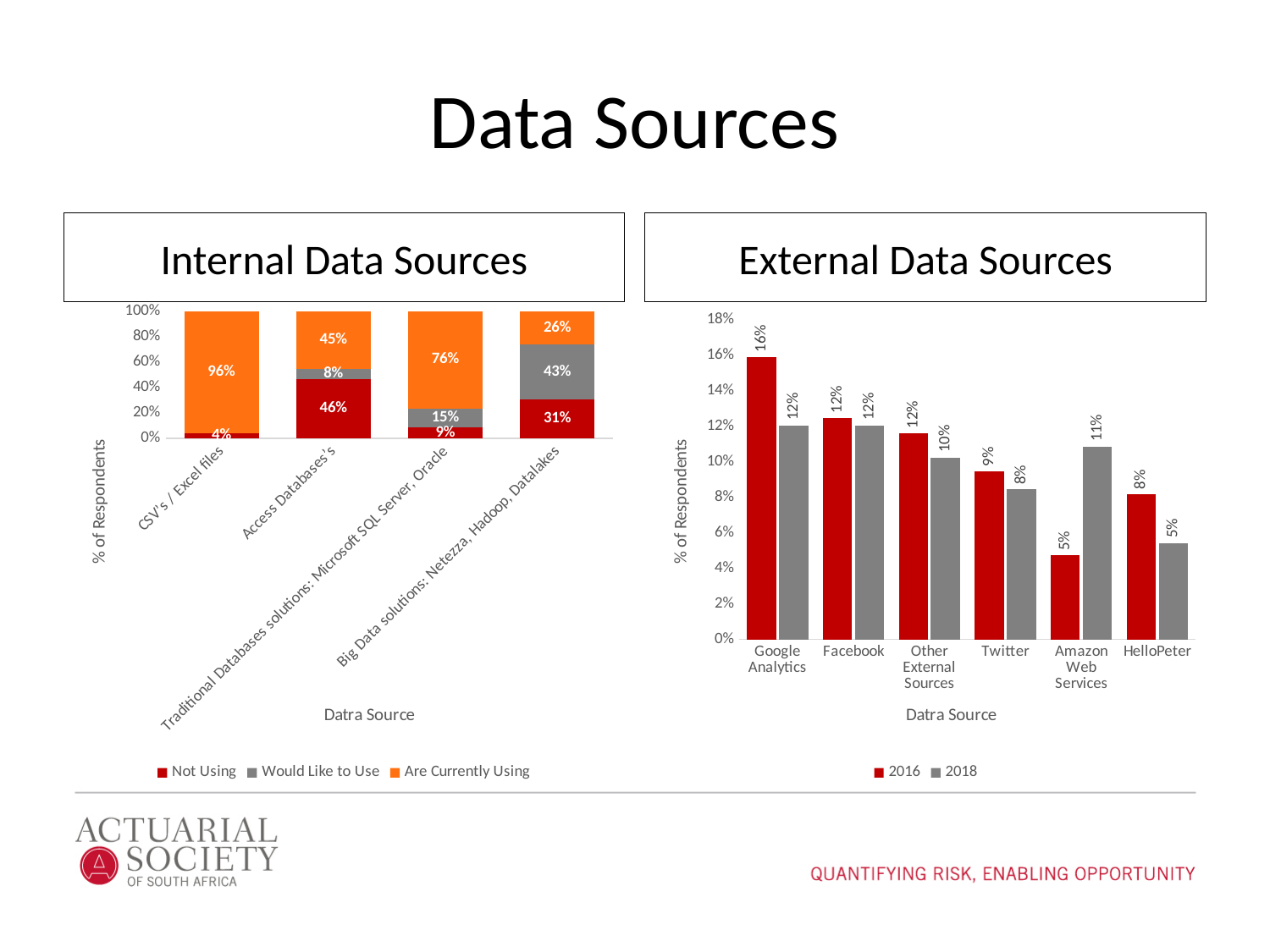
How many categories are shown on the x axis of the External Data Sources chart? 6 In the External Data Sources chart, which is larger for Amazon Web Services: the 2016 value or the 2018 value? 2018 What type of chart is the Internal Data Sources chart? Stacked bar chart In the External Data Sources chart, which category has the highest 2016 value? Google Analytics In the Internal Data Sources chart, what is the 'Would Like to Use' value for Big Data solutions: Netezza, Hadoop, Datalakes? 43% In the Internal Data Sources chart, which category has the highest 'Not Using' value? Access Databases's How many series does the legend of the External Data Sources chart list? 2 In the Internal Data Sources chart, what is the 'Are Currently Using' value for CSV's / Excel files? 96% In the External Data Sources chart, what is the 2016 value for Google Analytics? 16% In the External Data Sources chart, what is the 2018 value for Amazon Web Services? 11% In the External Data Sources chart, what is the difference between the 2016 and 2018 values for Google Analytics? 4% In the External Data Sources chart, which category has the lowest 2018 value? HelloPeter